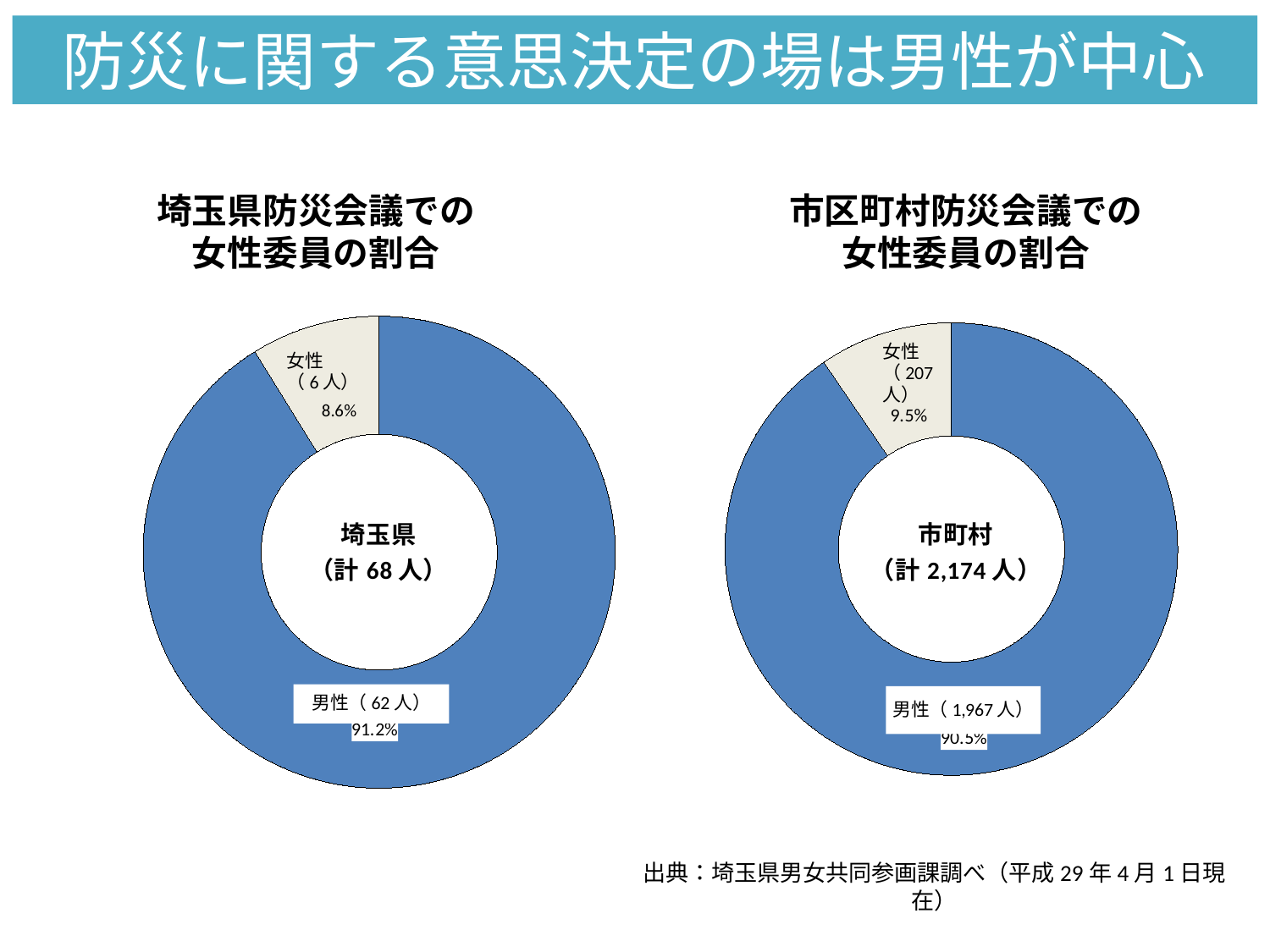
In the left chart (埼玉県防災会議での女性委員の割合), what percentage share is shown for 女性? 8.6% In the right chart (市区町村防災会議での女性委員の割合), what percentage share is shown for 女性? 9.5% In the left chart (埼玉県防災会議での女性委員の割合), what is the difference in number of people between 男性 and 女性? 56人 What kind of chart is used on this slide? Donut (pie) chart How many segments does the right chart (市区町村防災会議での女性委員の割合) have? 2 In the left chart (埼玉県防災会議での女性委員の割合), what is the total number of members shown in the centre? 計 68 人 In the right chart (市区町村防災会議での女性委員の割合), how many people are in the 女性 segment? 207人 In the left chart (埼玉県防災会議での女性委員の割合), how many people are in the 男性 segment? 62人 In the right chart (市区町村防災会議での女性委員の割合), what is the total number of members shown in the centre? 計 2,174 人 In the right chart (市区町村防災会議での女性委員の割合), how many people are in the 男性 segment? 1,967人 In the left chart (埼玉県防災会議での女性委員の割合), which segment is larger, 男性 or 女性? 男性 What is the title of the left chart? 埼玉県防災会議での女性委員の割合